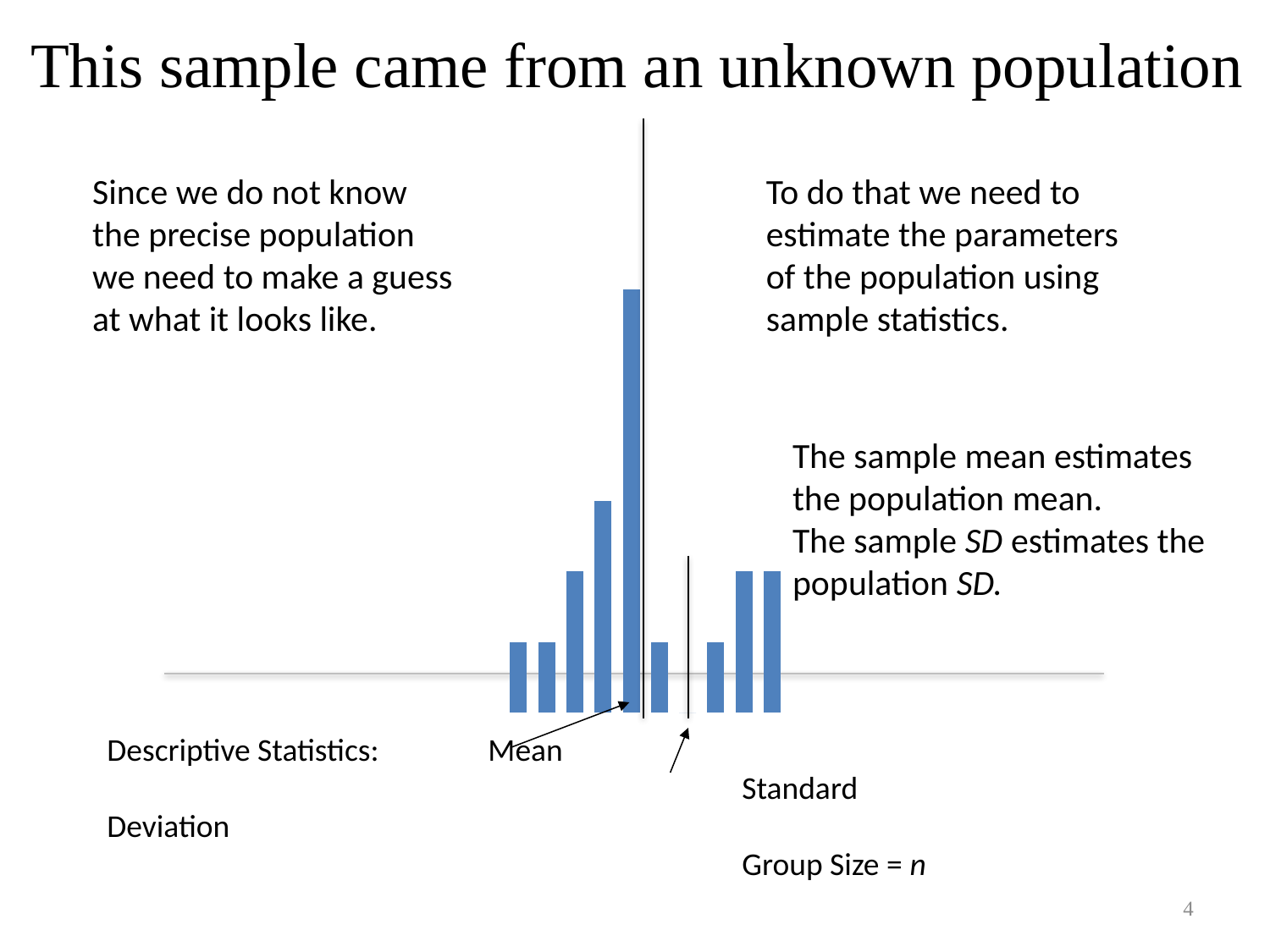
What kind of chart is shown on the slide? bar chart How many bars are plotted in the chart? 9 Counting from the left, which bar in the chart is the tallest? the fifth bar Which of the two labelled vertical lines on the chart is the taller one, the Mean line or the Standard Deviation line? the Mean line What colour are the bars in the chart? blue